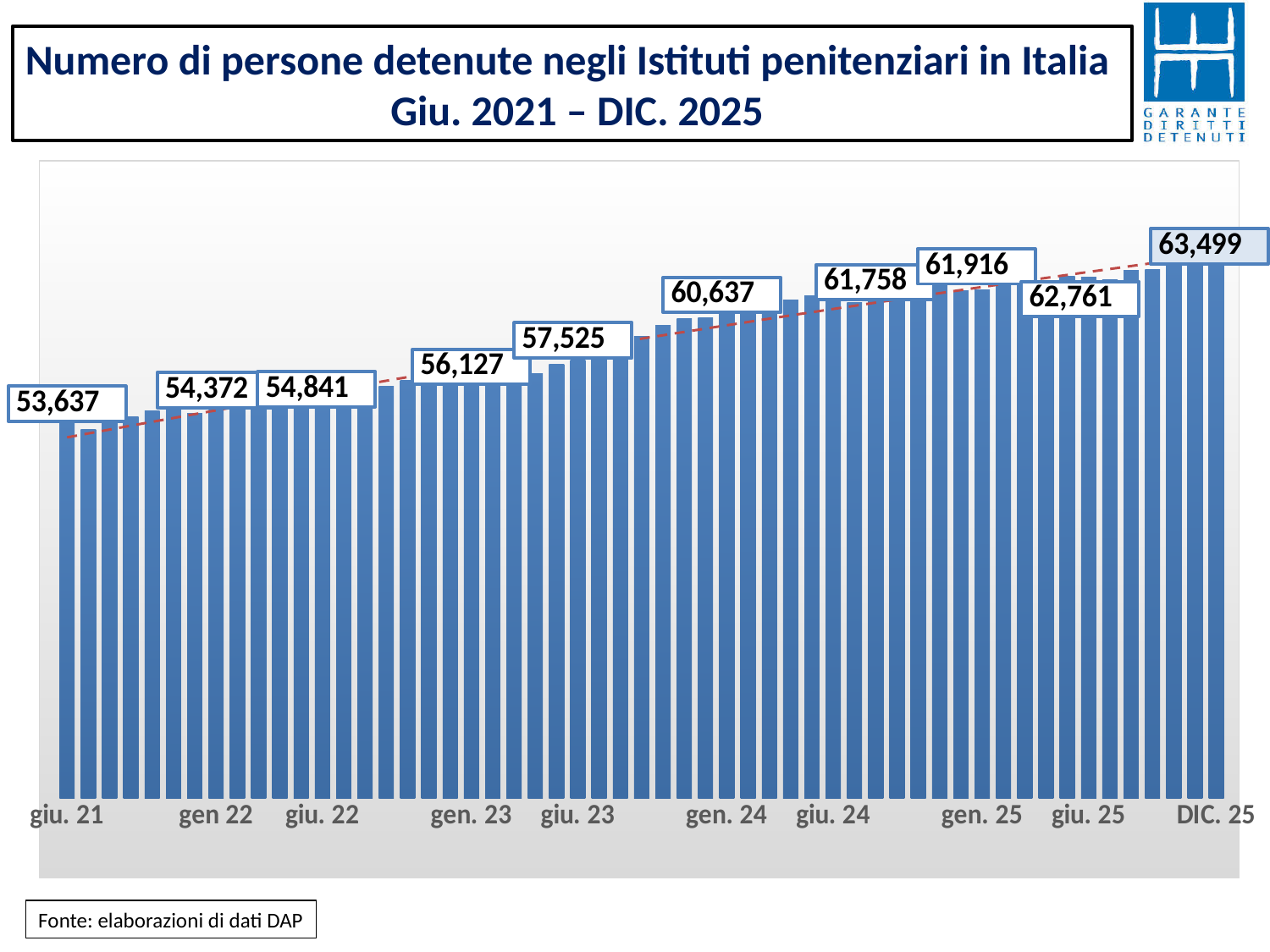
What is the difference between the labelled values for gen. 24 and giu. 23? 3,112 What is the title of the chart? Numero di persone detenute negli Istituti penitenziari in Italia Giu. 2021 – DIC. 2025 Which labelled period has the highest value? DIC. 25 What value is labelled for DIC. 25? 63,499 What value is labelled for giu. 23? 57,525 What value is labelled for gen. 24? 60,637 What is the difference between the value for DIC. 25 and the value for giu. 21? 9,862 Which labelled period has the lowest value? giu. 21 What is the number of detained persons shown for giu. 21? 53,637 What type of chart is shown on the slide? Bar chart Which is larger, the value for giu. 24 or the value for gen. 25? gen. 25 Do the values rise or fall from giu. 21 to DIC. 25? Rise